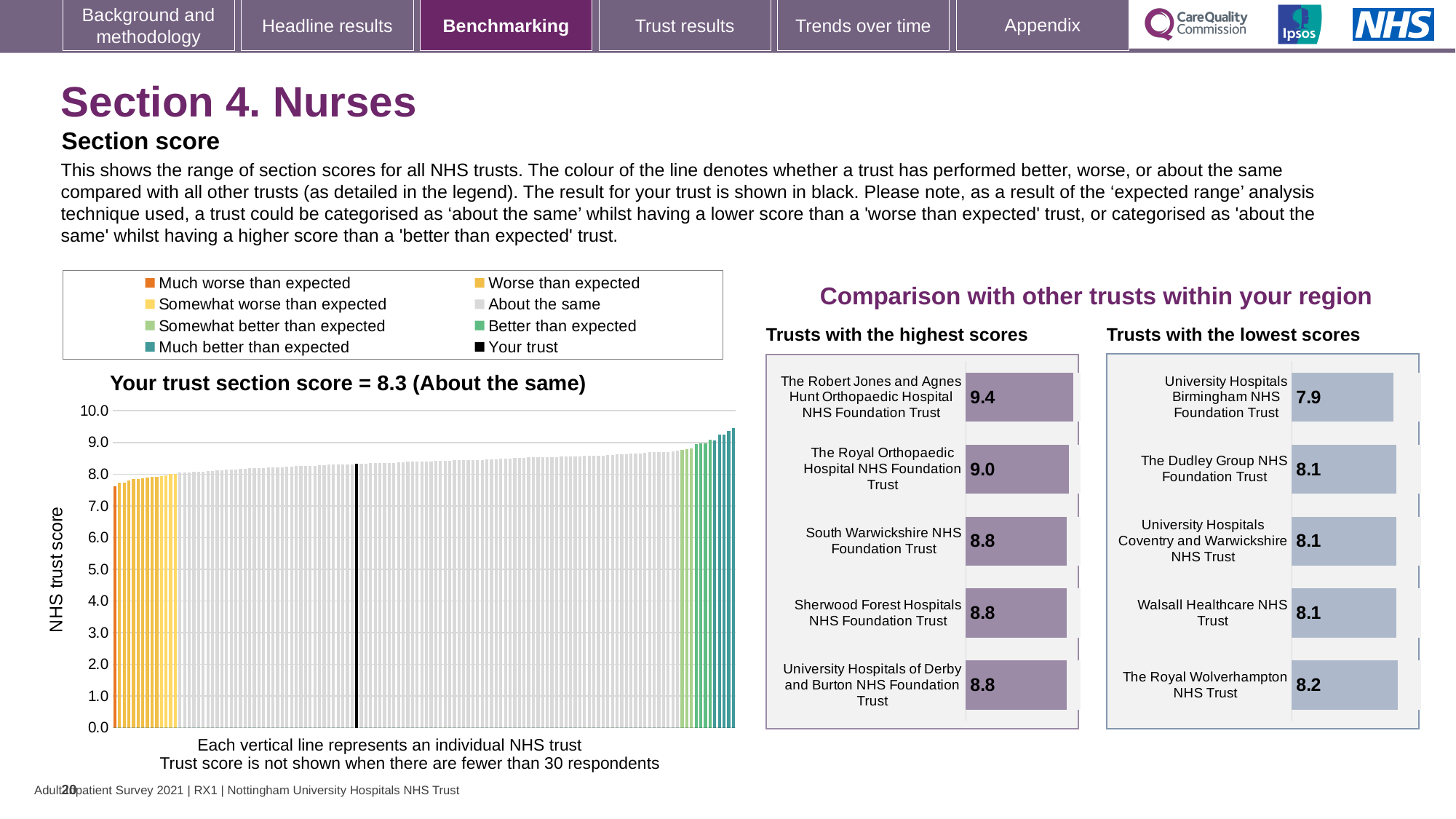
In the 'Trusts with the highest scores' chart, what is the difference between the scores of The Robert Jones and Agnes Hunt Orthopaedic Hospital NHS Foundation Trust and The Royal Orthopaedic Hospital NHS Foundation Trust? 0.4 What kind of chart is the 'Your trust section score' chart? Bar chart In the 'Your trust section score' chart, what category is your trust's score placed in? About the same In the 'Your trust section score' chart, do the trust scores rise or fall from left to right? Rise In the 'Trusts with the highest scores' chart, which trust has the highest score? The Robert Jones and Agnes Hunt Orthopaedic Hospital NHS Foundation Trust In the 'Trusts with the lowest scores' chart, which trust has the lowest score? University Hospitals Birmingham NHS Foundation Trust In the 'Trusts with the lowest scores' chart, which has the larger score: The Dudley Group NHS Foundation Trust or University Hospitals Birmingham NHS Foundation Trust? The Dudley Group NHS Foundation Trust How many trusts are shown in the 'Trusts with the highest scores' chart? 5 How many entries does the legend above the 'Your trust section score' chart list? 8 In the 'Your trust section score' chart, what is the section score for your trust? 8.3 In the 'Trusts with the highest scores' chart, what is the score for The Robert Jones and Agnes Hunt Orthopaedic Hospital NHS Foundation Trust? 9.4 In the 'Trusts with the lowest scores' chart, what is the score for The Royal Wolverhampton NHS Trust? 8.2